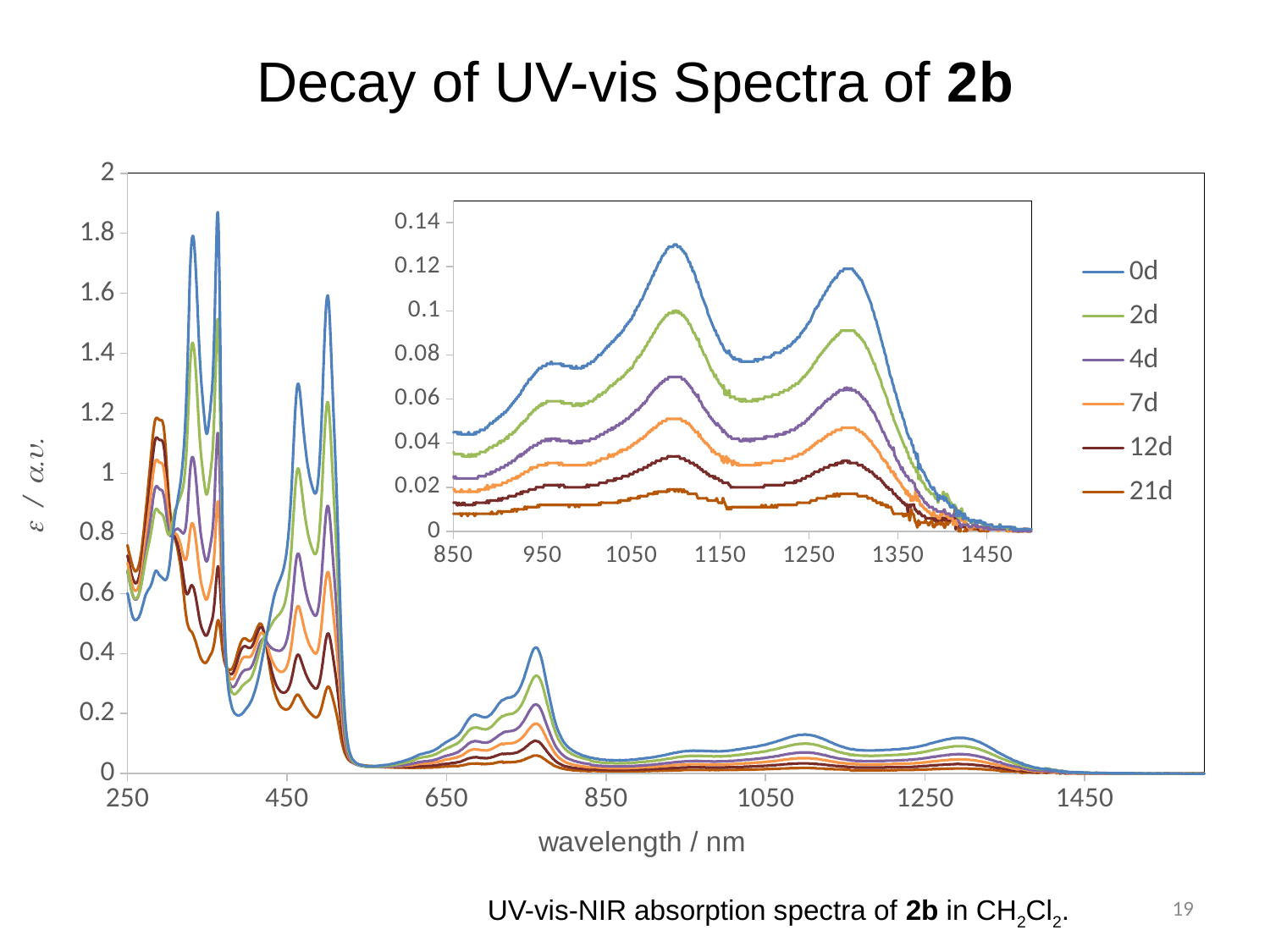
What is the x-axis label of the main chart? wavelength / nm How many series does the legend of the main chart list? 6 In the inset chart, do the peak heights rise or fall as the number of days increases from 0d to 21d? fall In the main chart, is the highest peak of the 0d series (near 370 nm) greater or less than 1.8? greater In the main chart, is the peak of the 0d series near 770 nm greater or less than 0.3? greater In the inset chart, which series has the highest peak near 1100 nm? 0d What kind of chart is the main chart on the slide? line chart In the inset chart, is the value of the 21d series near 1100 nm greater or less than 0.04? less In the inset chart, which series has the lowest curve across the plotted range? 21d Which series is listed last in the legend of the main chart? 21d In the inset chart, which series has the larger value near 1300 nm, 2d or 12d? 2d